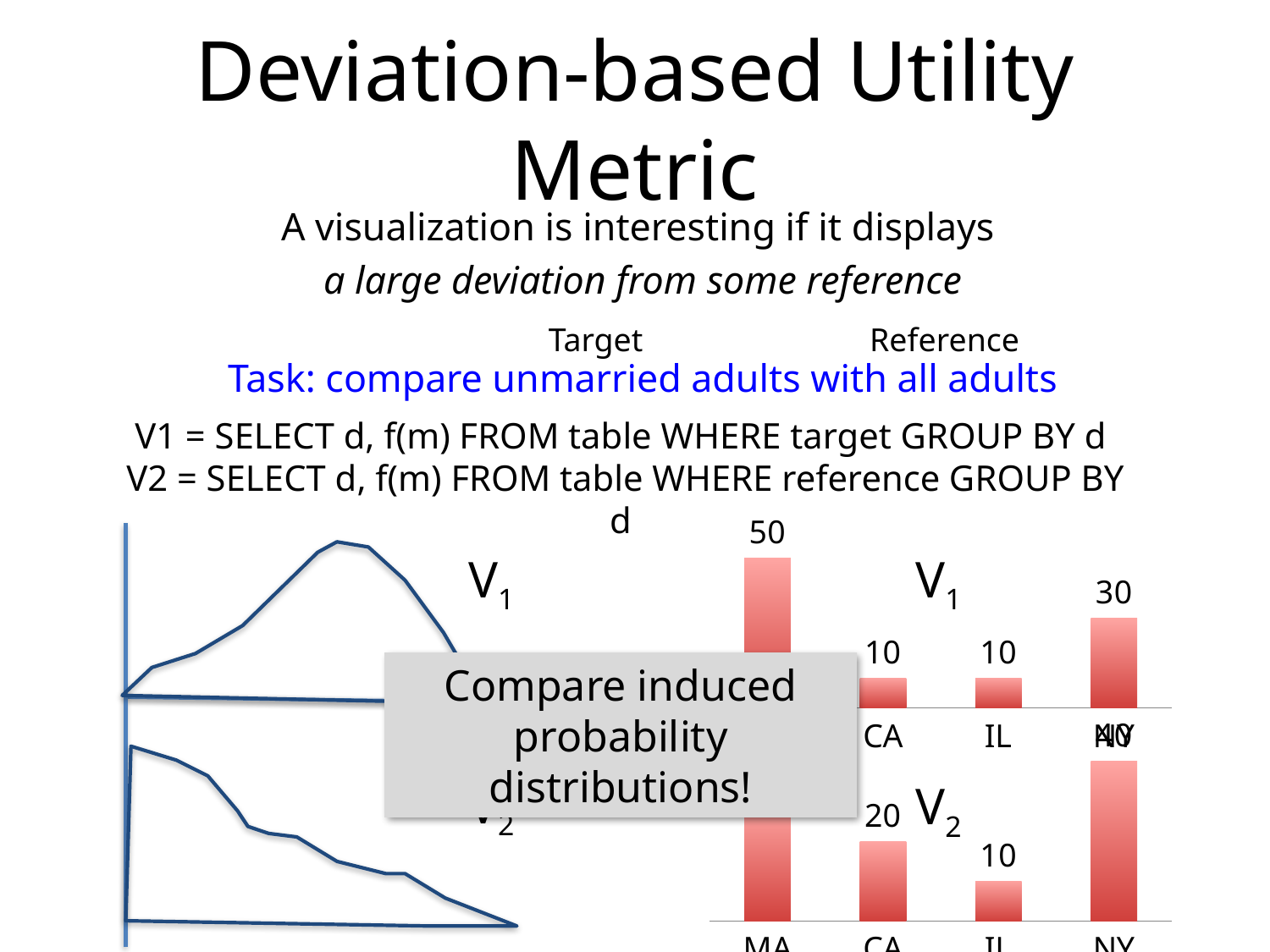
In the V2 bar chart on the right, what is the value for CA? 20 What kind of chart is the V2 chart on the lower left of the slide? line chart In the V1 bar chart on the right, what is the value for CA? 10 How many categories are shown on the x axis of the V2 bar chart on the right? 4 In the V1 bar chart on the right, what is the value of the tallest bar? 50 In the V1 bar chart on the right, what is the difference between the values for NY and CA? 20 In the V1 bar chart on the right, what is the value for IL? 10 In the V2 bar chart on the right, what is the value for IL? 10 In the V1 bar chart on the right, what is the value for NY? 30 In the V2 bar chart on the right, what is the difference between the values for CA and IL? 10 In the V1 bar chart on the right, which is larger, the value for NY or the value for IL? NY In the V2 bar chart on the right, which is larger, the value for CA or the value for IL? CA